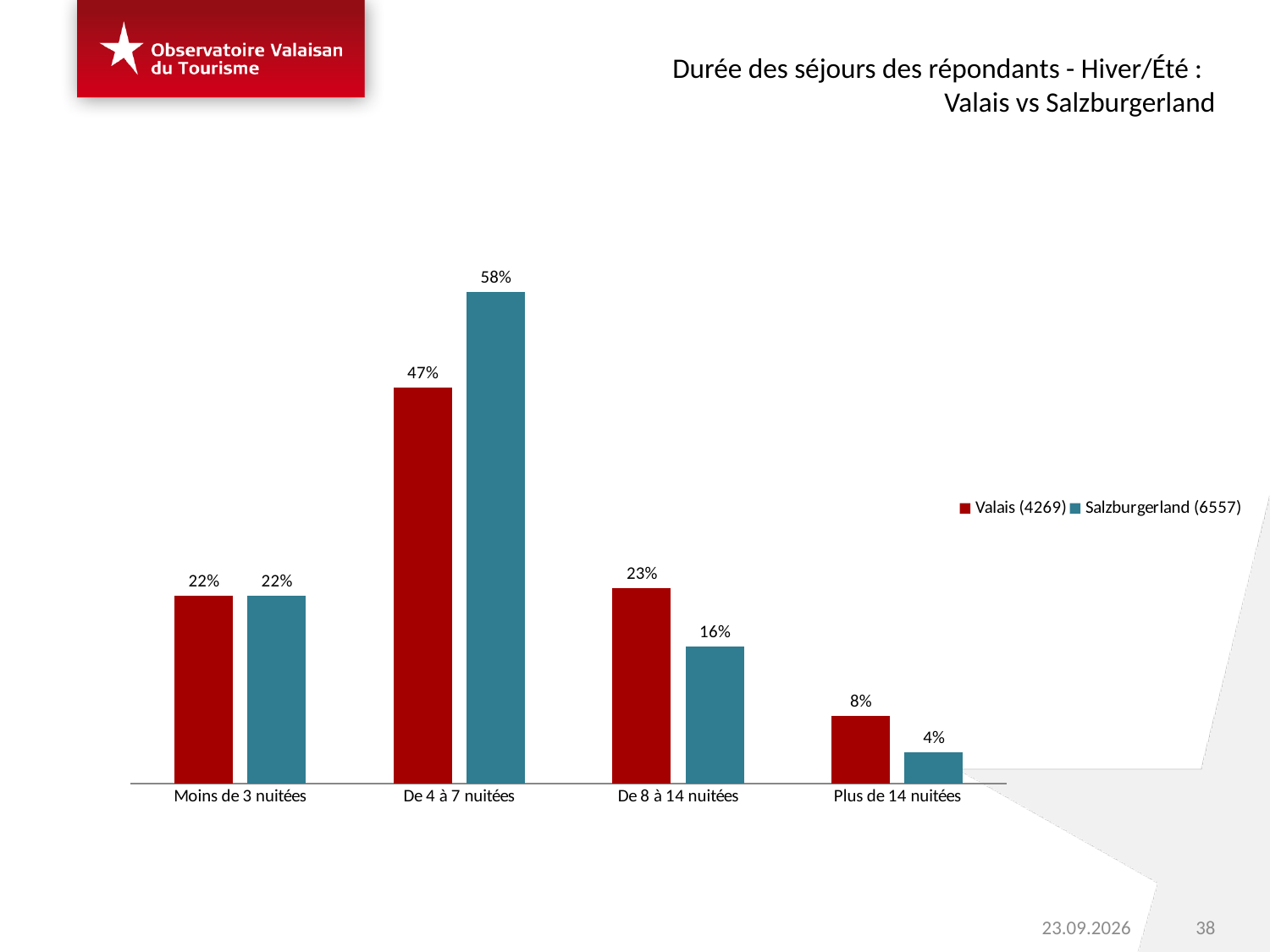
How many categories are shown on the x axis? 4 In the 'De 8 à 14 nuitées' category, which series has the larger value, Valais (4269) or Salzburgerland (6557)? Valais (4269) Which category has the lowest value for Valais (4269)? Plus de 14 nuitées What is the value for Salzburgerland (6557) in the 'De 8 à 14 nuitées' category? 16% What kind of chart is shown on the slide? Bar chart Which category has the highest value for Salzburgerland (6557)? De 4 à 7 nuitées What colour are the bars for Salzburgerland (6557)? Teal blue What is the value for Salzburgerland (6557) in the 'Plus de 14 nuitées' category? 4% How many series does the legend list? 2 What is the difference between the Salzburgerland (6557) and Valais (4269) values in the 'De 4 à 7 nuitées' category? 11% What is the title of the chart? Durée des séjours des répondants - Hiver/Été : Valais vs Salzburgerland What is the value for Valais (4269) in the 'De 4 à 7 nuitées' category? 47%